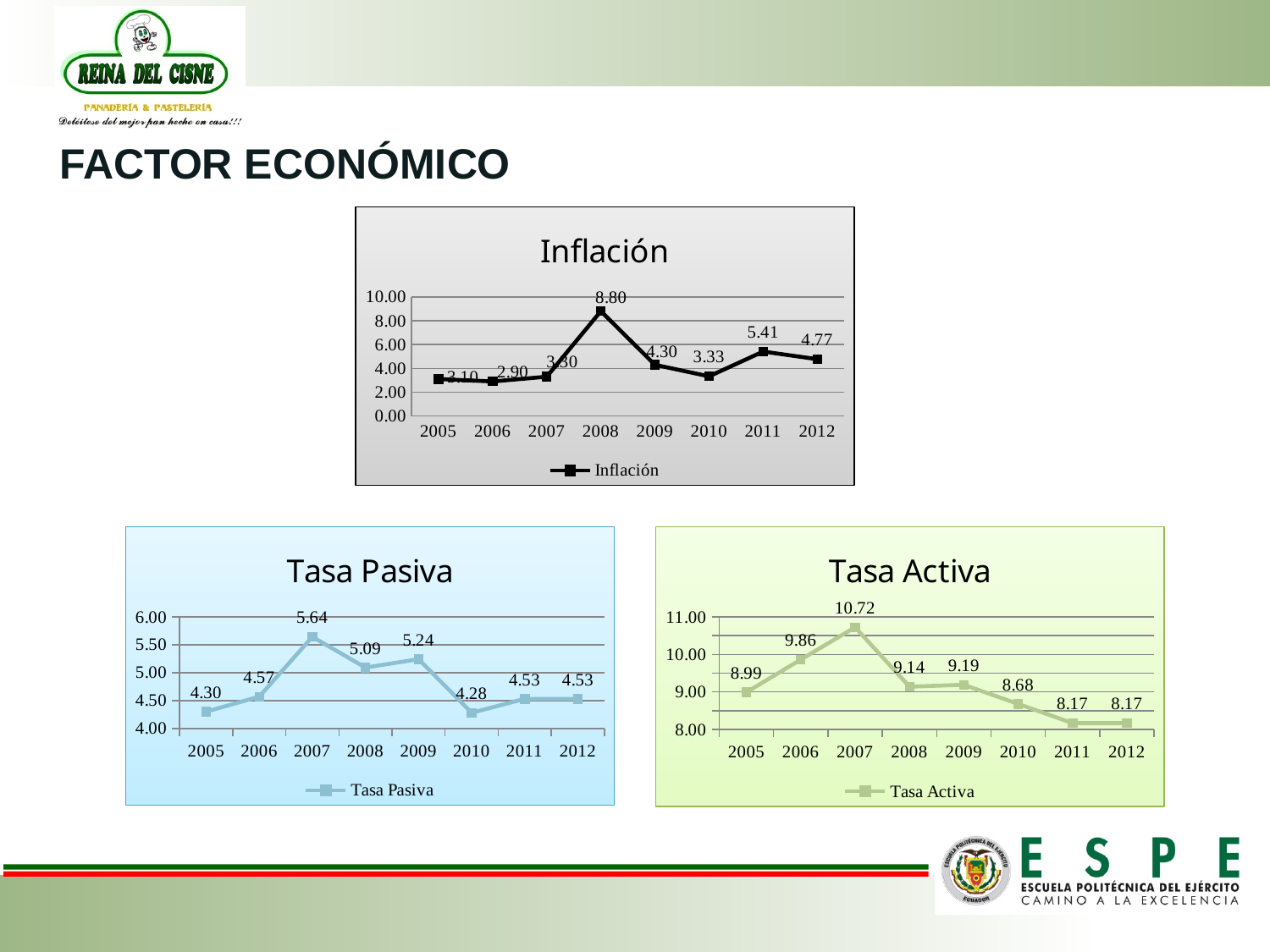
In the Inflación chart, what is the difference between the values for 2011 and 2012? 0.64 In the Inflación chart, which year has the highest value? 2008 In the Tasa Activa chart, do the values rise or fall from 2009 to 2011? fall In the Tasa Pasiva chart, what is the value for 2007? 5.64 In the Tasa Pasiva chart, which year has the lowest value? 2010 In the Tasa Activa chart, what is the difference between the values for 2006 and 2005? 0.87 How many years are plotted in the Tasa Activa chart? 8 In the Tasa Activa chart, what is the value for 2007? 10.72 In the Inflación chart, what is the value for 2008? 8.80 What kind of chart is the Tasa Pasiva chart? line chart In the Tasa Pasiva chart, which is larger, the value for 2008 or the value for 2009? 2009 In the Inflación chart, which year has the lowest value? 2006